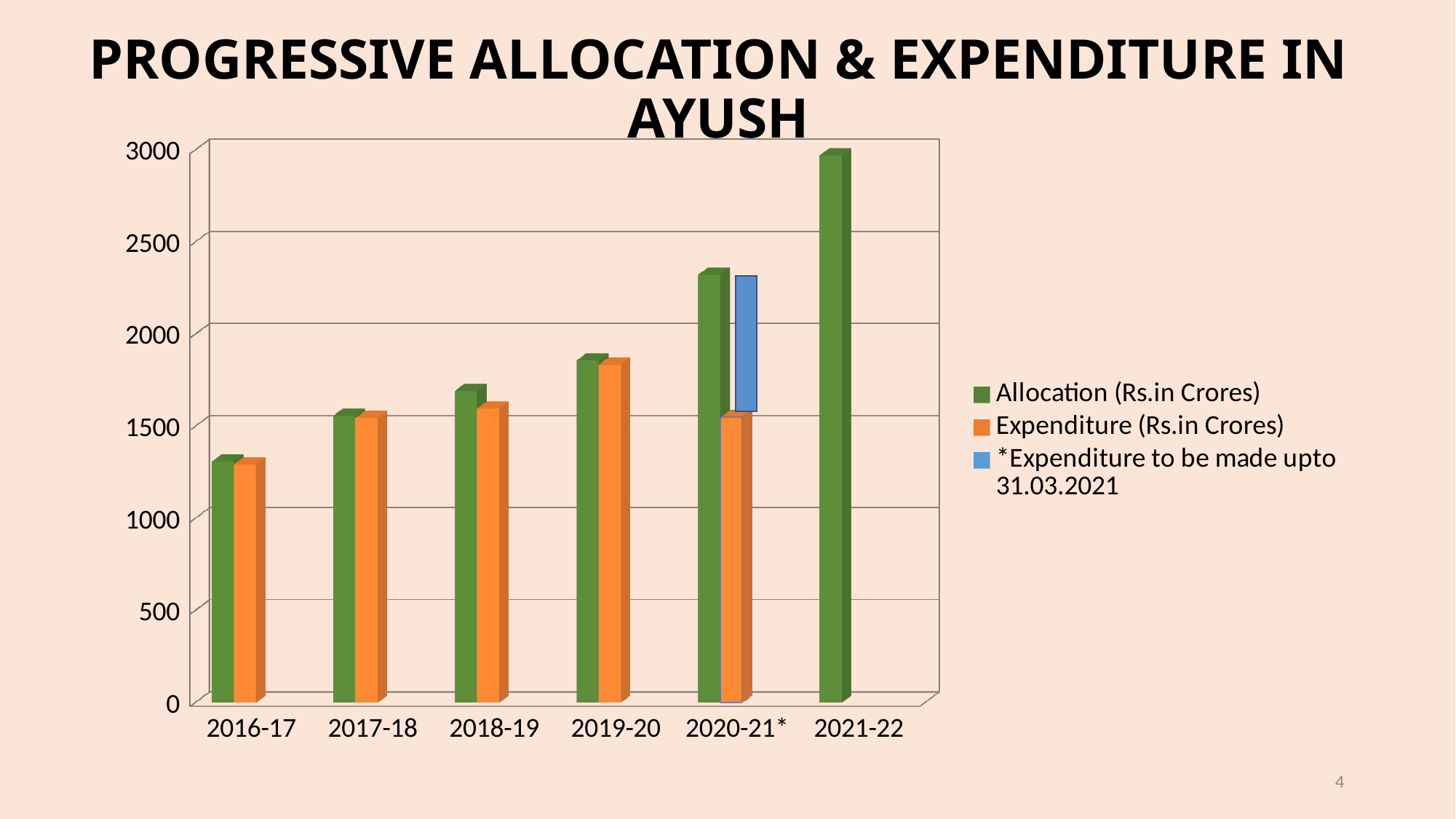
Does the Allocation rise or fall from 2016-17 to 2021-22? rise Which year has the lowest Allocation (Rs.in Crores)? 2016-17 How many series does the legend list? 3 Is the Allocation for 2021-22 greater or less than 2500? greater In 2020-21*, which is larger, the Allocation or the Expenditure? Allocation Which series is shown in blue in the legend? *Expenditure to be made upto 31.03.2021 Is the Allocation for 2016-17 greater or less than 1500? less What kind of chart is shown on the slide? bar chart How many fiscal years are shown on the x axis? 6 Is the Allocation for 2020-21* greater or less than 2000? greater Which year has the highest Allocation (Rs.in Crores)? 2021-22 Which year has the highest Expenditure (Rs.in Crores)? 2019-20